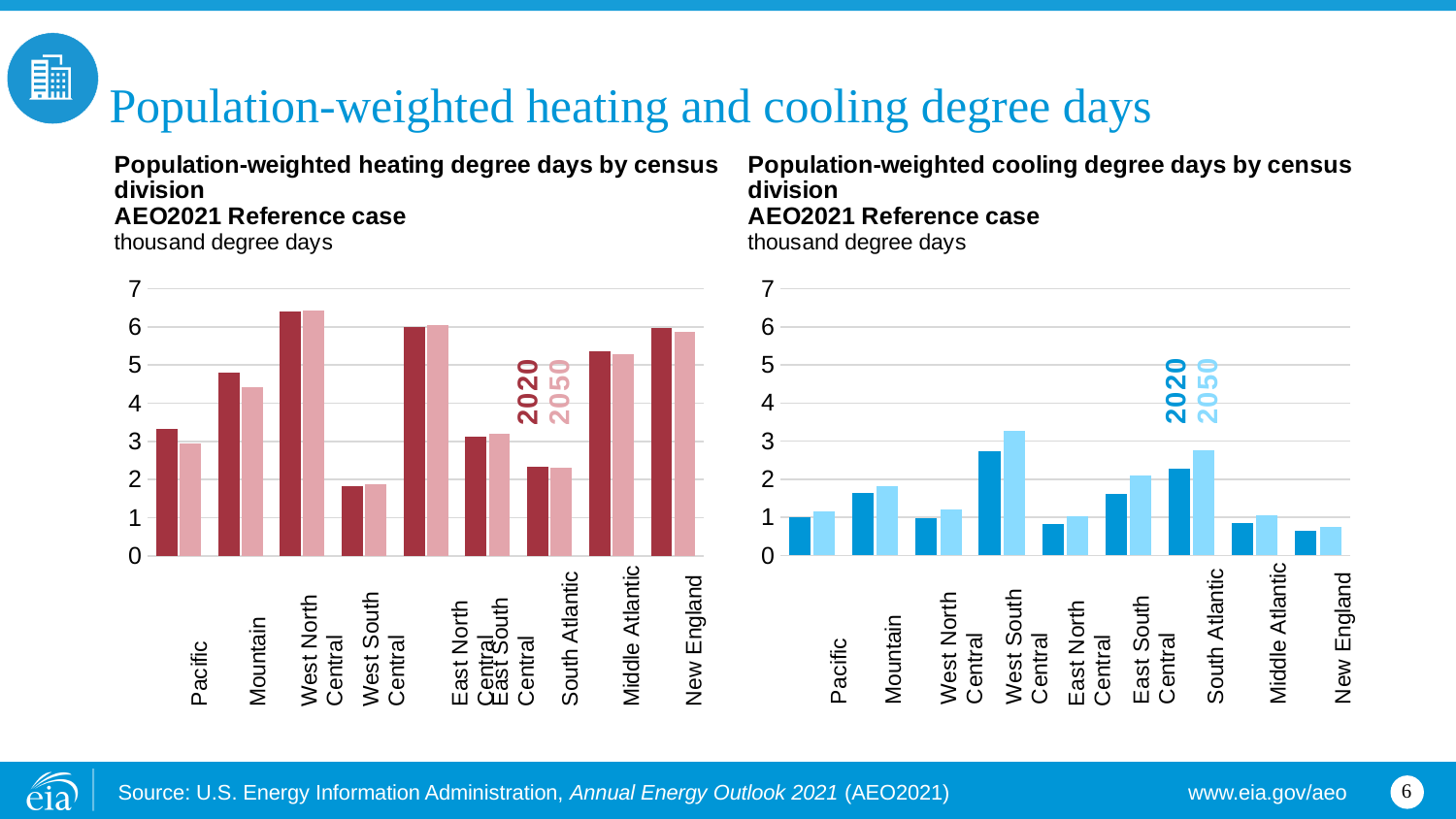
In the heating degree days chart on the left, which census division has the lowest values? West South Central In the heating degree days chart on the left, is the 2020 value for West South Central greater or less than 2? less In the cooling degree days chart on the right, is the 2050 value for West South Central greater or less than 3? greater In the cooling degree days chart on the right, is the 2020 value for New England greater or less than 1? less In the cooling degree days chart on the right, which census division has the highest values? West South Central In the heating degree days chart on the left, which is larger for Pacific: the 2020 value or the 2050 value? 2020 In the cooling degree days chart on the right, which is larger for South Atlantic: the 2020 value or the 2050 value? 2050 In the cooling degree days chart on the right, which census division has the lowest values? New England What kind of chart is the population-weighted heating degree days chart on the left? bar chart How many census divisions are shown in the cooling degree days chart on the right? 9 In the heating degree days chart on the left, which census division has the highest values? West North Central